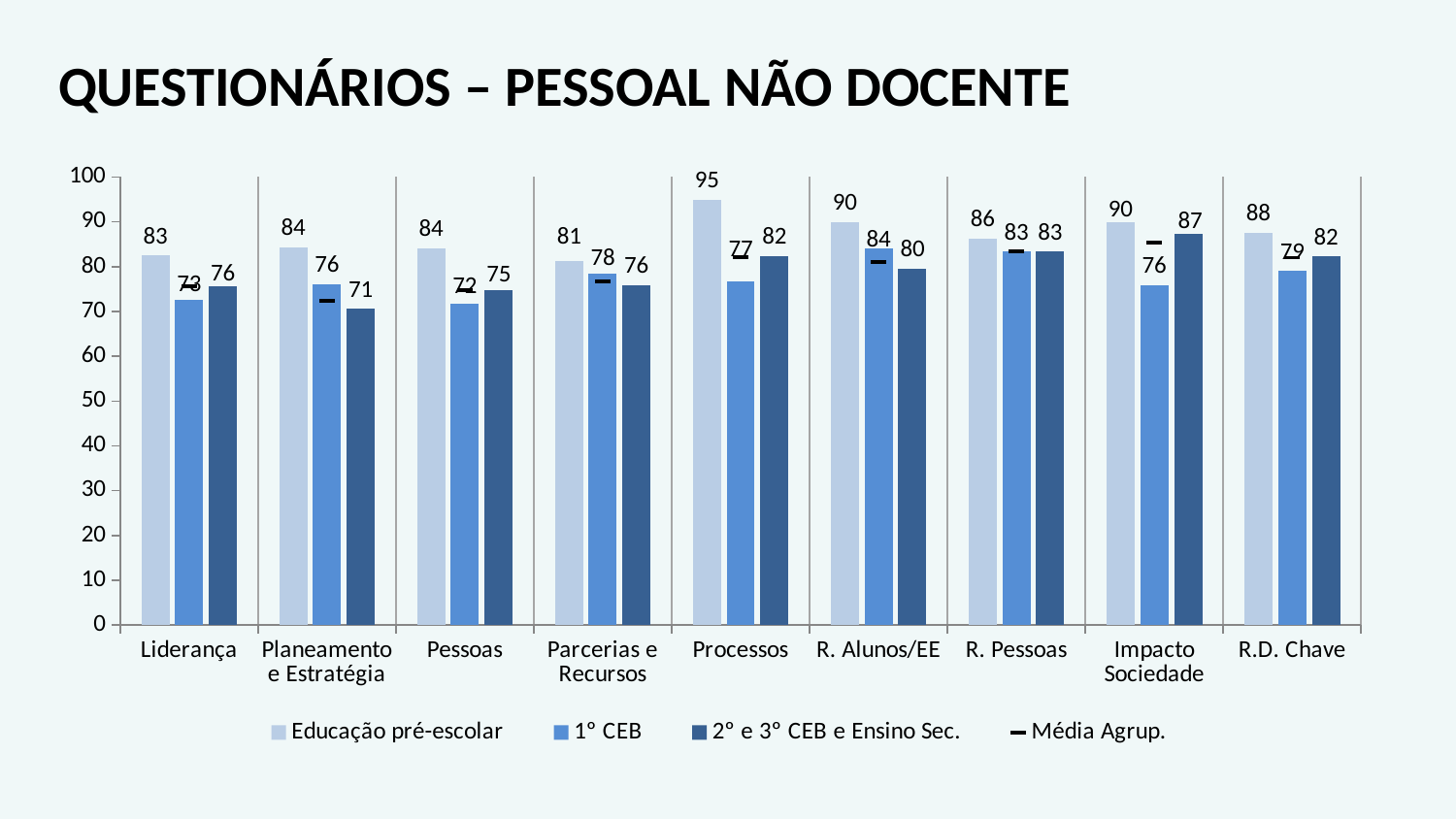
What is the value for 2° e 3° CEB e Ensino Sec. in the Impacto Sociedade category? 87 How many categories are shown on the x axis of the chart? 9 What is the value for 1° CEB in the R. Alunos/EE category? 84 Which category has the highest value for Educação pré-escolar? Processos In the Impacto Sociedade category, which is larger: the 1° CEB value or the 2° e 3° CEB e Ensino Sec. value? 2° e 3° CEB e Ensino Sec. In the Processos category, what is the difference between the Educação pré-escolar value and the 2° e 3° CEB e Ensino Sec. value? 13 What kind of chart is shown on the slide? Bar chart What is the title of the slide? QUESTIONÁRIOS – PESSOAL NÃO DOCENTE In the Planeamento e Estratégia category, what is the difference between the Educação pré-escolar value and the 1° CEB value? 8 Which category has the lowest value for 2° e 3° CEB e Ensino Sec.? Planeamento e Estratégia How many entries does the chart legend list? 4 What is the value for Educação pré-escolar in the Processos category? 95